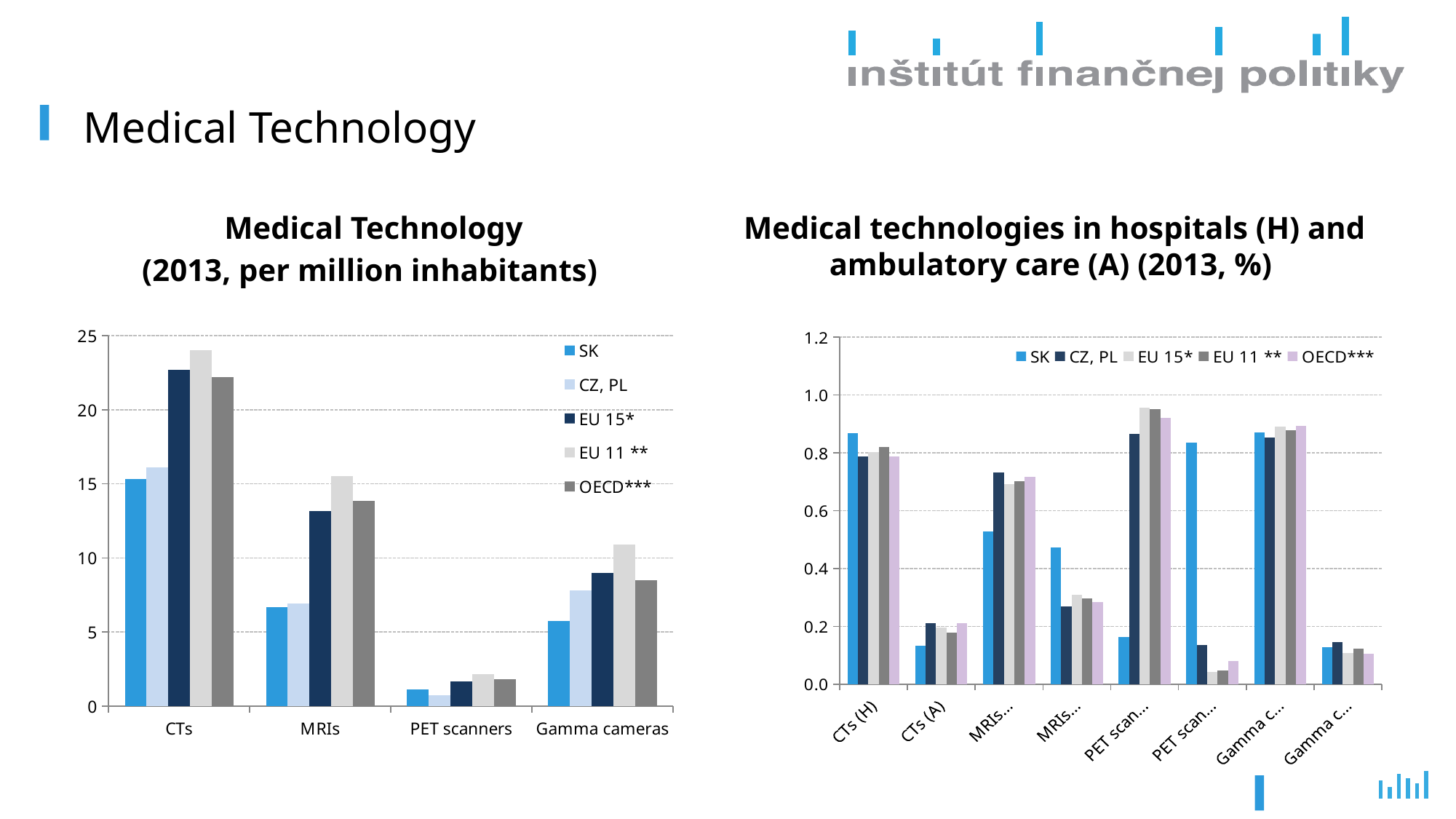
In the left chart, 'Medical Technology (2013, per million inhabitants)', which category has the lowest value for SK? PET scanners What kind of chart is the left chart, 'Medical Technology (2013, per million inhabitants)'? bar chart How many categories are shown on the x axis of the left chart, 'Medical Technology (2013, per million inhabitants)'? 4 In the left chart, 'Medical Technology (2013, per million inhabitants)', is the value for SK for MRIs greater or less than 10? less In the right chart, 'Medical technologies in hospitals (H) and ambulatory care (A) (2013, %)', which is larger for CTs (A): SK or EU 15*? EU 15* How many categories are shown on the x axis of the right chart, 'Medical technologies in hospitals (H) and ambulatory care (A) (2013, %)'? 8 How many series does the legend of the right chart, 'Medical technologies in hospitals (H) and ambulatory care (A) (2013, %)', list? 5 In the right chart, 'Medical technologies in hospitals (H) and ambulatory care (A) (2013, %)', is the value for SK for CTs (H) greater or less than 0.8? greater How many series does the legend of the left chart, 'Medical Technology (2013, per million inhabitants)', list? 5 In the left chart, 'Medical Technology (2013, per million inhabitants)', is the value for EU 11 ** for CTs greater or less than 20? greater In the left chart, 'Medical Technology (2013, per million inhabitants)', which series has the highest value for CTs? EU 11 ** In the left chart, 'Medical Technology (2013, per million inhabitants)', which is larger for Gamma cameras: SK or EU 11 **? EU 11 **